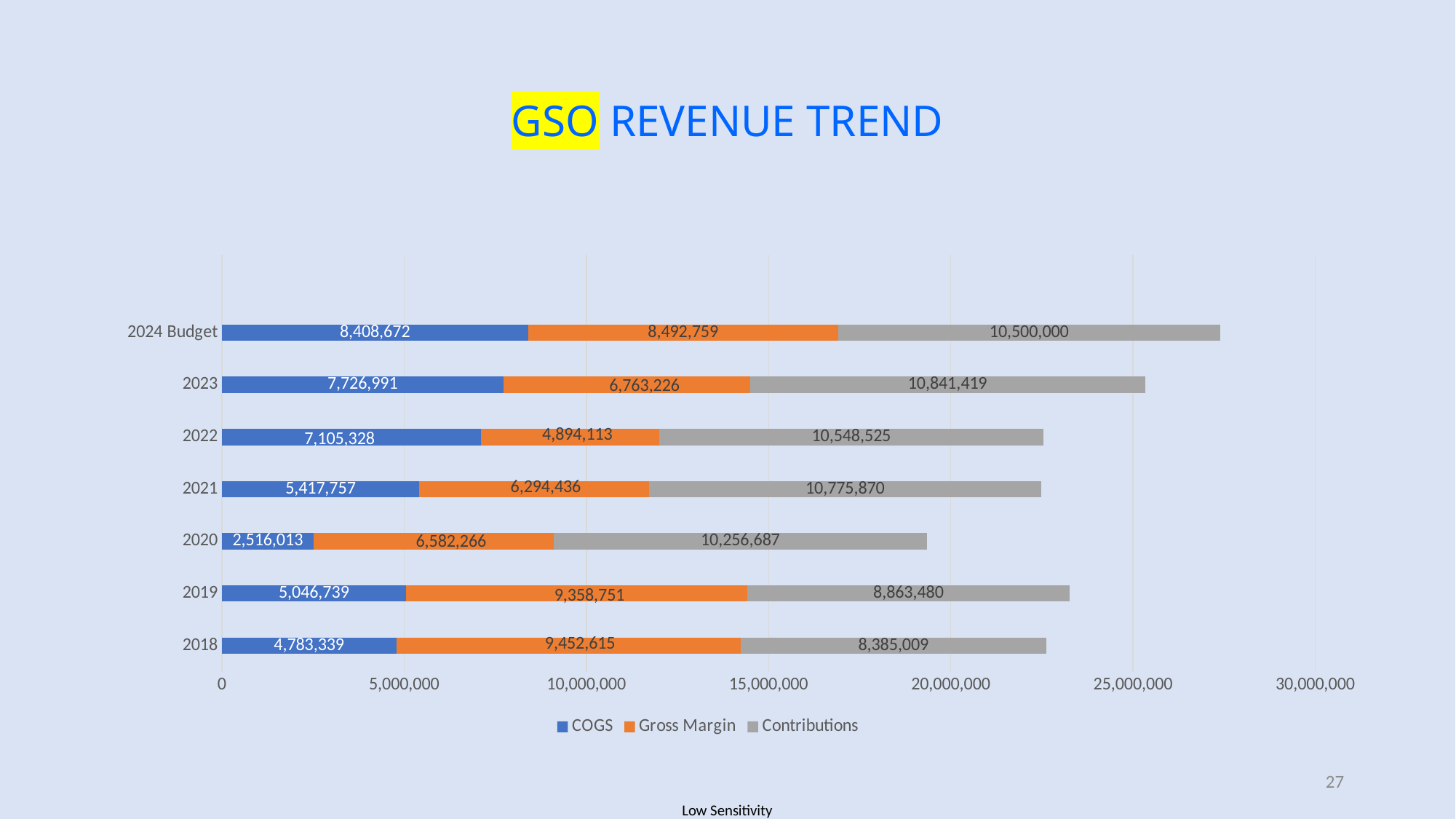
What is the total of the stacked bar for 2024 Budget? 27,401,431 How many series does the legend list? 3 What is the difference between the Contributions value for 2023 and for 2024 Budget? 341,419 Which year has the highest Contributions value? 2023 Which is larger, the Gross Margin value for 2020 or for 2021? 2020 What is the Gross Margin value for 2022? 4,894,113 How many years (categories) are shown on the chart? 7 What is the COGS value for 2024 Budget? 8,408,672 Which year has the lowest COGS value? 2020 What type of chart is shown on the slide? Stacked bar chart What is the Contributions value for 2021? 10,775,870 What is the total of the stacked bar for 2020? 19,354,966